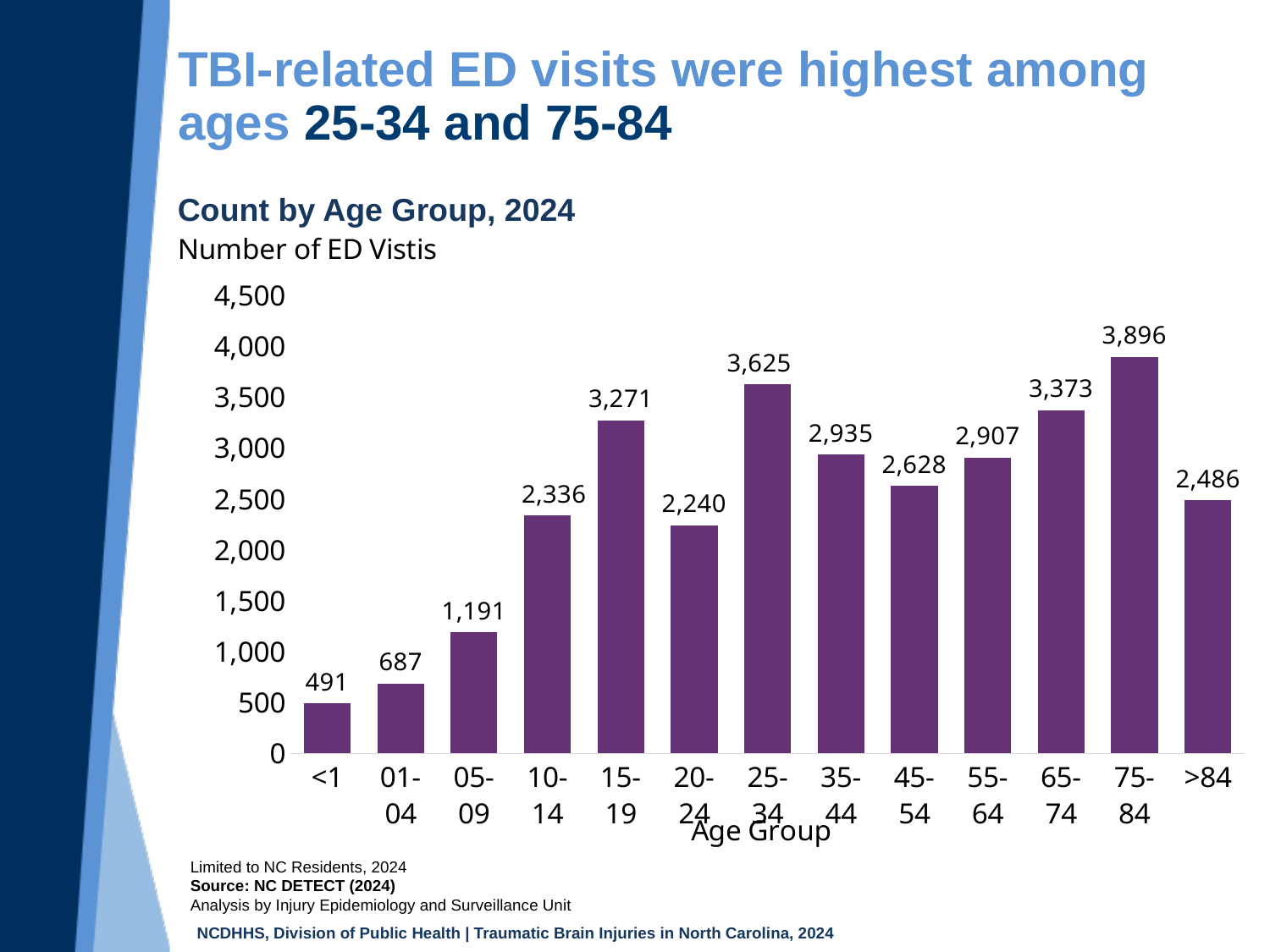
How many age groups are shown on the chart? 13 What is the difference in ED visits between the 15-19 and 20-24 age groups? 1,031 What is the difference in ED visits between the 75-84 and 25-34 age groups? 271 What type of chart is shown on the slide? bar chart Which age group has more ED visits, 35-44 or 55-64? 35-44 What is the number of ED visits for the 25-34 age group? 3,625 What is the label of the x axis? Age Group Which age group has the highest number of ED visits? 75-84 Is the value for the 65-74 age group greater or less than 3,000? greater What is the number of ED visits for the <1 age group? 491 What is the number of ED visits for the >84 age group? 2,486 Which age group has the lowest number of ED visits? <1